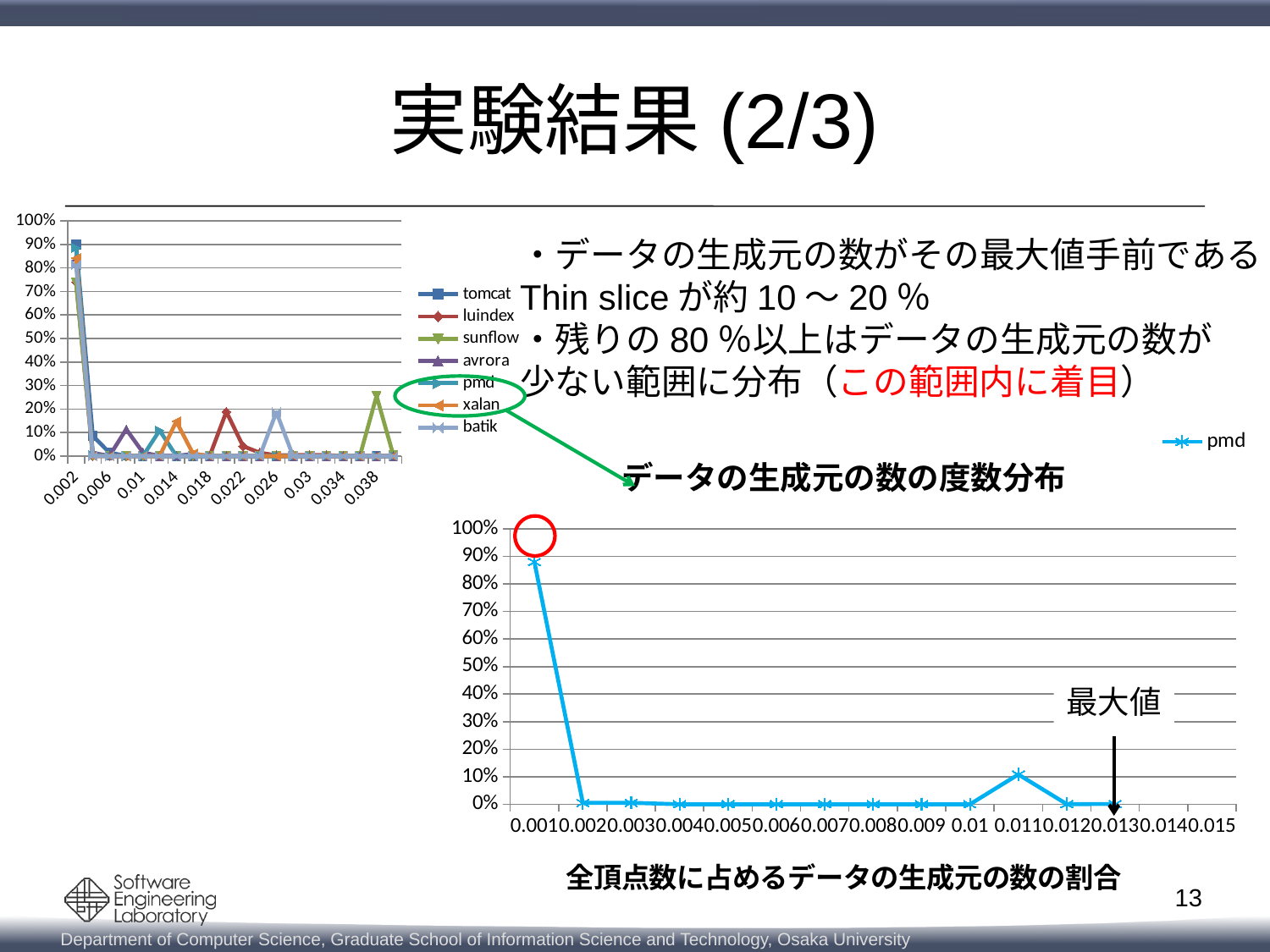
In the large chart at the bottom right, which is larger: the pmd value at 0.001 or at 0.011? 0.001 What kind of chart is the large chart at the bottom right of the slide? line chart How many series does the legend of the small chart at the top left list? 7 In the large chart at the bottom right, is the pmd value at 0.001 greater or less than 80%? greater In the large chart at the bottom right, is the pmd value at 0.011 greater or less than 20%? less How many series does the legend of the large chart at the bottom right list? 1 Which series name appears in the legend of the large chart at the bottom right? pmd In the large chart at the bottom right, which x-axis value has the highest pmd value? 0.001 In the small chart at the top left, is the sunflow value at 0.038 greater or less than 20%? greater In the large chart at the bottom right, does the pmd line rise or fall from 0.001 to 0.002? fall How many x-axis tick labels are shown on the large chart at the bottom right? 15